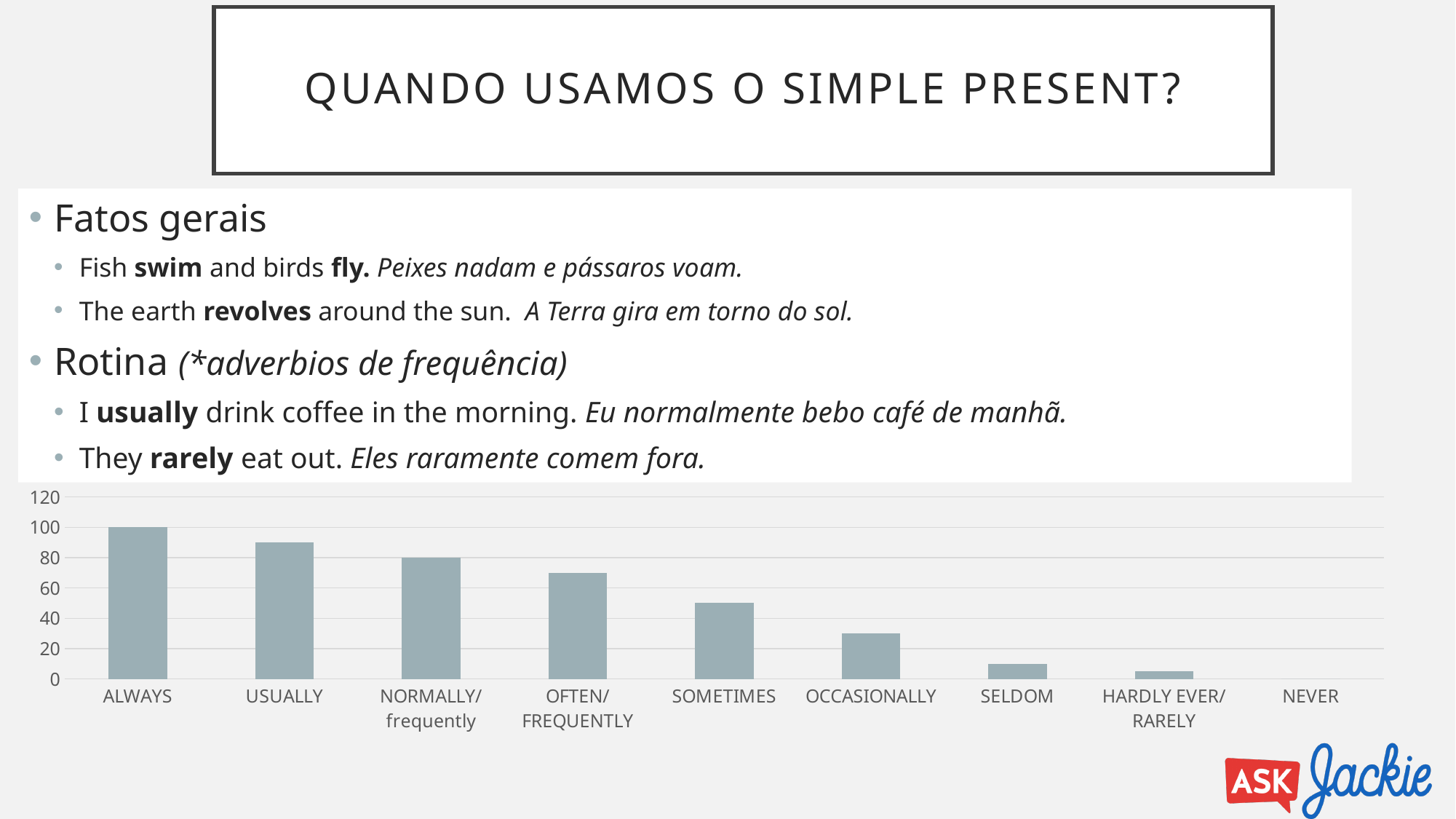
What is the value for ALWAYS in the chart? 100 Is the value for SOMETIMES greater or less than 60? less Which is larger, the value for SOMETIMES or the value for SELDOM? SOMETIMES Which category has the lowest value in the chart? NEVER Is the value for OCCASIONALLY greater or less than 20? greater Which category has the highest bar in the chart? ALWAYS What is the value for NORMALLY/frequently in the chart? 80 How many categories are shown on the x axis of the chart? 9 Is the value for USUALLY greater or less than 80? greater What is the difference between the values for ALWAYS and NORMALLY/frequently? 20 What kind of chart is shown at the bottom of the slide? bar chart Do the values rise or fall from left to right along the x axis? fall